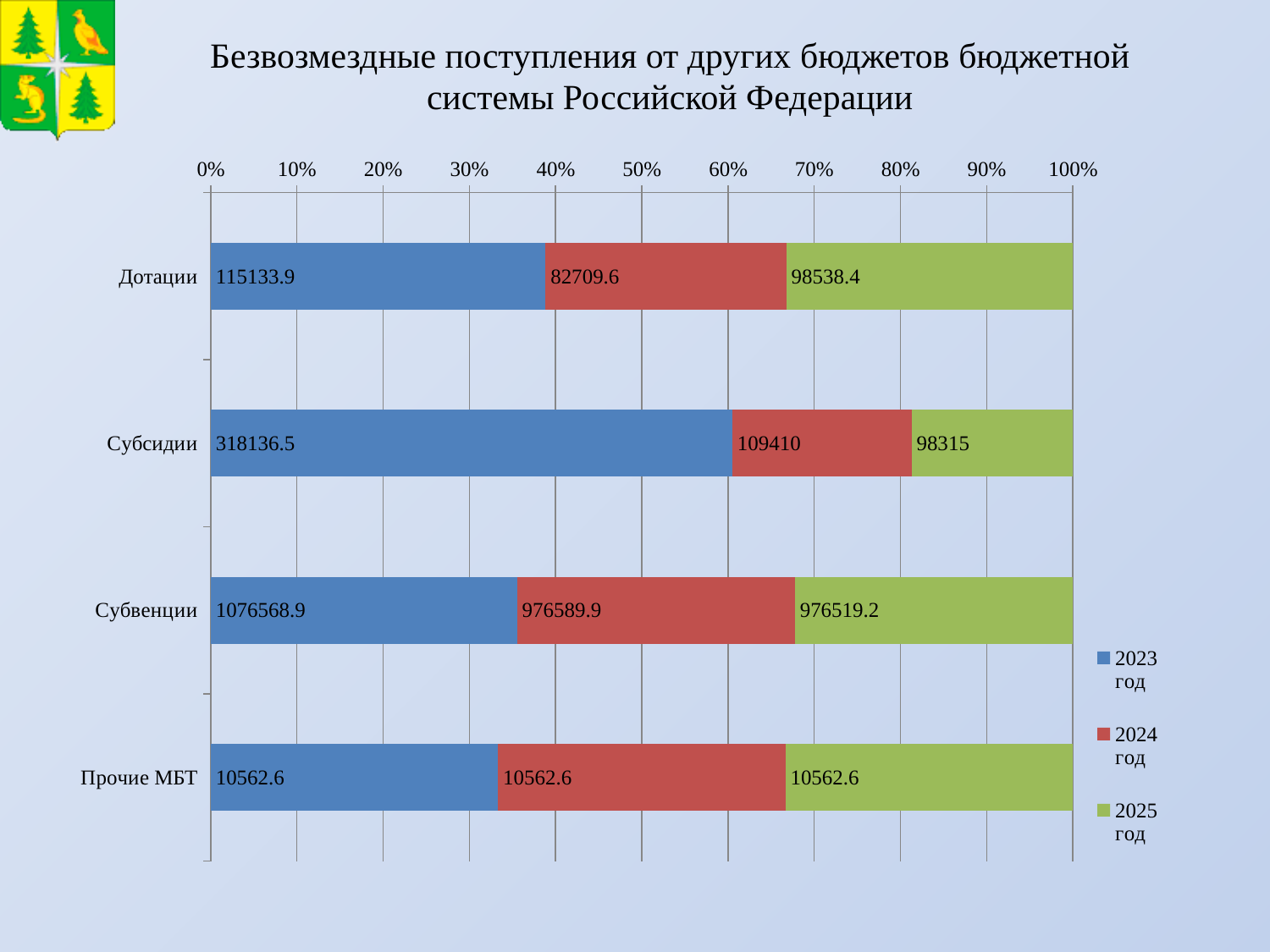
How many series does the legend list? 3 What is the value for Субсидии in the 2024 год series? 109410 What is the difference between the 2023 год and 2024 год values for Дотации? 32424.3 Which category has the lowest value in the 2025 год series? Прочие МБТ What kind of chart is shown on the slide? Stacked bar chart What is the value for Субвенции in the 2025 год series? 976519.2 What is the difference between the 2023 год and 2024 год values for Субсидии? 208726.5 What is the value for Дотации in the 2023 год series? 115133.9 For Дотации, which is larger: the 2024 год value or the 2025 год value? 2025 год What is the value for Прочие МБТ in the 2023 год series? 10562.6 Which category has the highest value in the 2023 год series? Субвенции How many categories are shown on the chart? 4